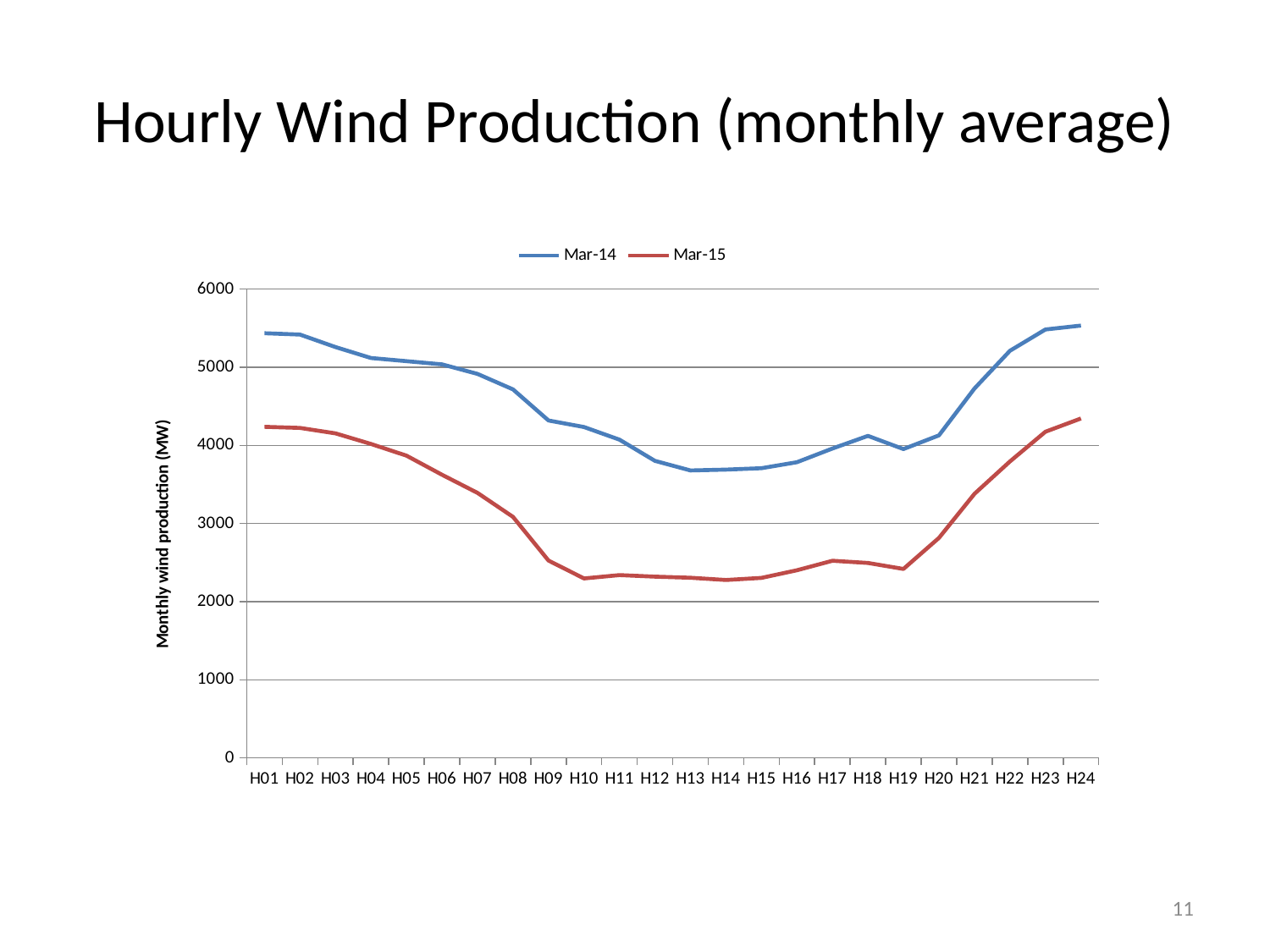
What kind of chart is shown on the slide? line chart Is the Mar-15 value at H24 greater or less than 4000? greater Is the Mar-14 value at H13 greater or less than 4000? less Is the Mar-14 value at H09 greater or less than 4000? greater How many hourly categories are plotted along the x axis? 24 What is the label on the vertical axis? Monthly wind production (MW) At H12, which series has the larger value, Mar-14 or Mar-15? Mar-14 Does the Mar-15 line rise or fall from H01 to H10? fall Does the Mar-14 line rise or fall from H19 to H24? rise How many series does the legend list? 2